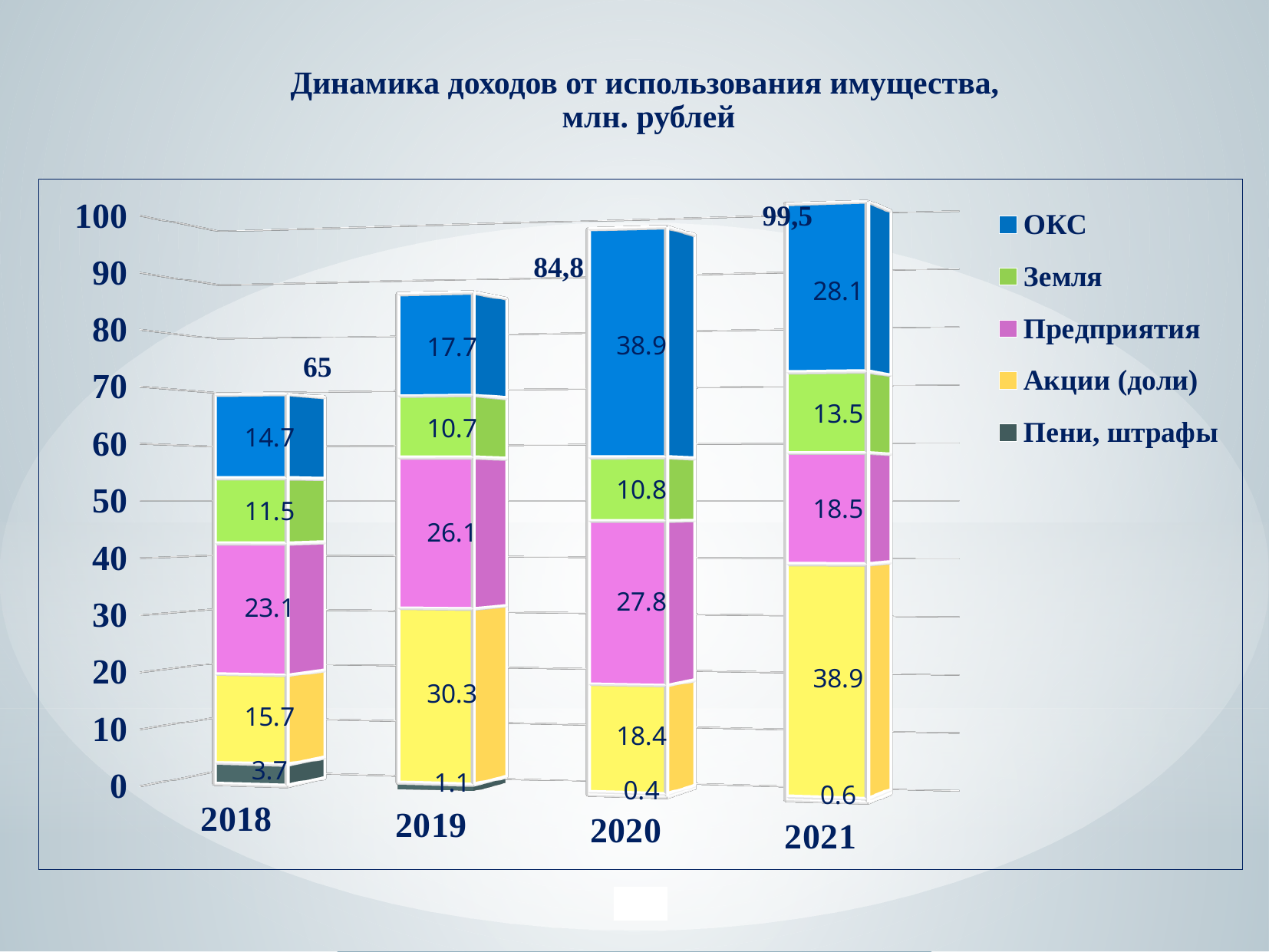
What is the total printed above the 2021 bar? 99,5 What is the value of Пени, штрафы for 2018? 3.7 Which is larger, the ОКС value for 2019 or for 2021? 2021 Which year has the lowest value for Земля? 2019 What is the total of the 2019 stacked bar? 85.9 What is the value of Акции (доли) for 2019? 30.3 What is the difference between the Предприятия values for 2020 and 2021? 9.3 How many years are shown on the x axis? 4 What is the value of ОКС for 2020? 38.9 Which year has the highest total income? 2021 How many series does the legend list? 5 What type of chart is shown on the slide? stacked bar chart